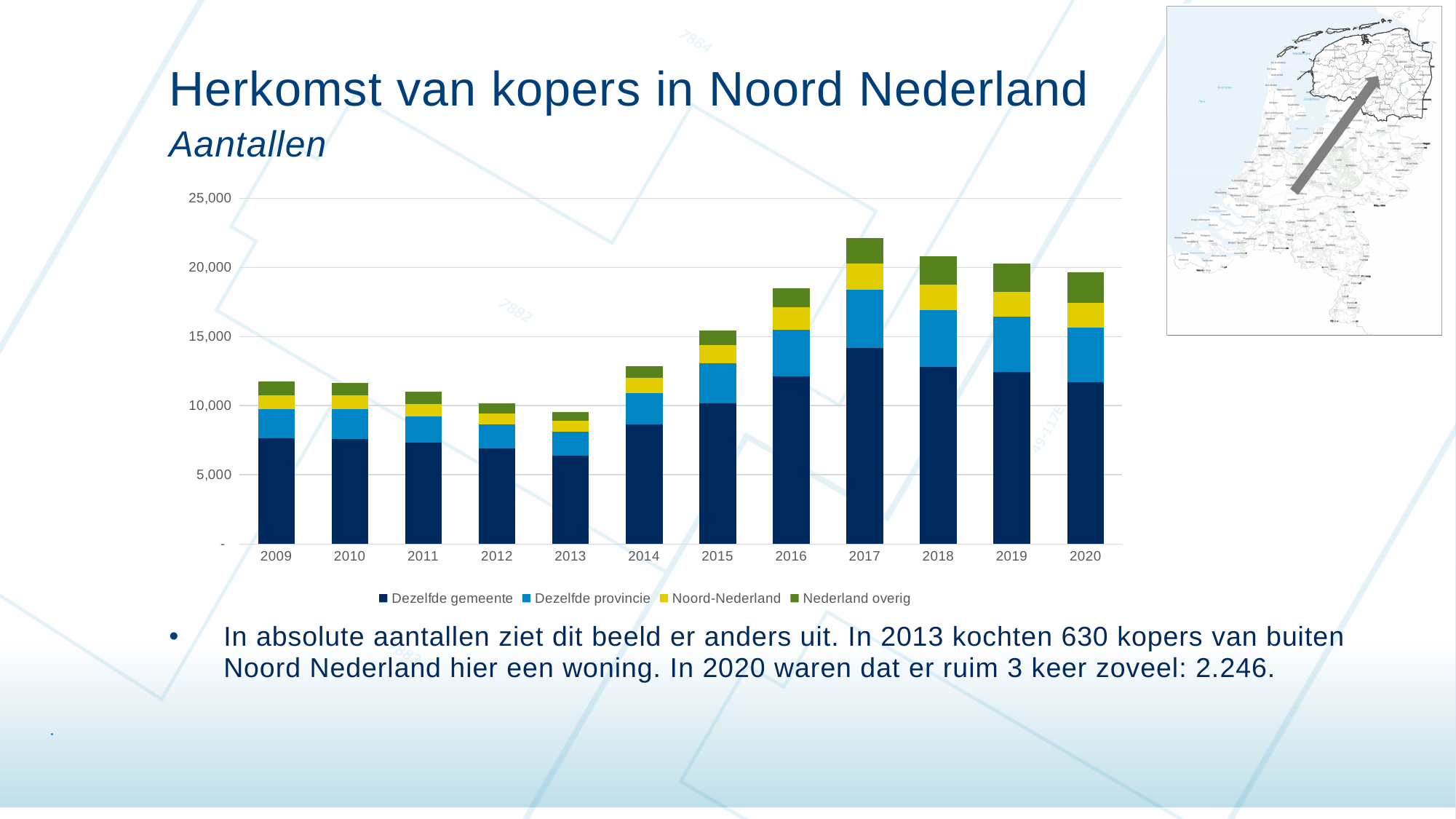
Which year has a larger total bar, 2013 or 2017? 2017 Is the total for 2013 greater or less than 10,000? less Which year has the lowest total bar in the chart? 2013 How many series does the chart's legend list? 4 Is the total for 2016 greater or less than 20,000? less Do the total bars rise or fall from 2013 to 2017? rise Which year has the highest total bar in the chart? 2017 What kind of chart is shown on the slide? Stacked bar chart Is the 'Dezelfde gemeente' value for 2017 greater or less than 10,000? greater How many years are shown on the x axis of the chart? 12 Which series is shown in dark blue at the bottom of each bar? Dezelfde gemeente